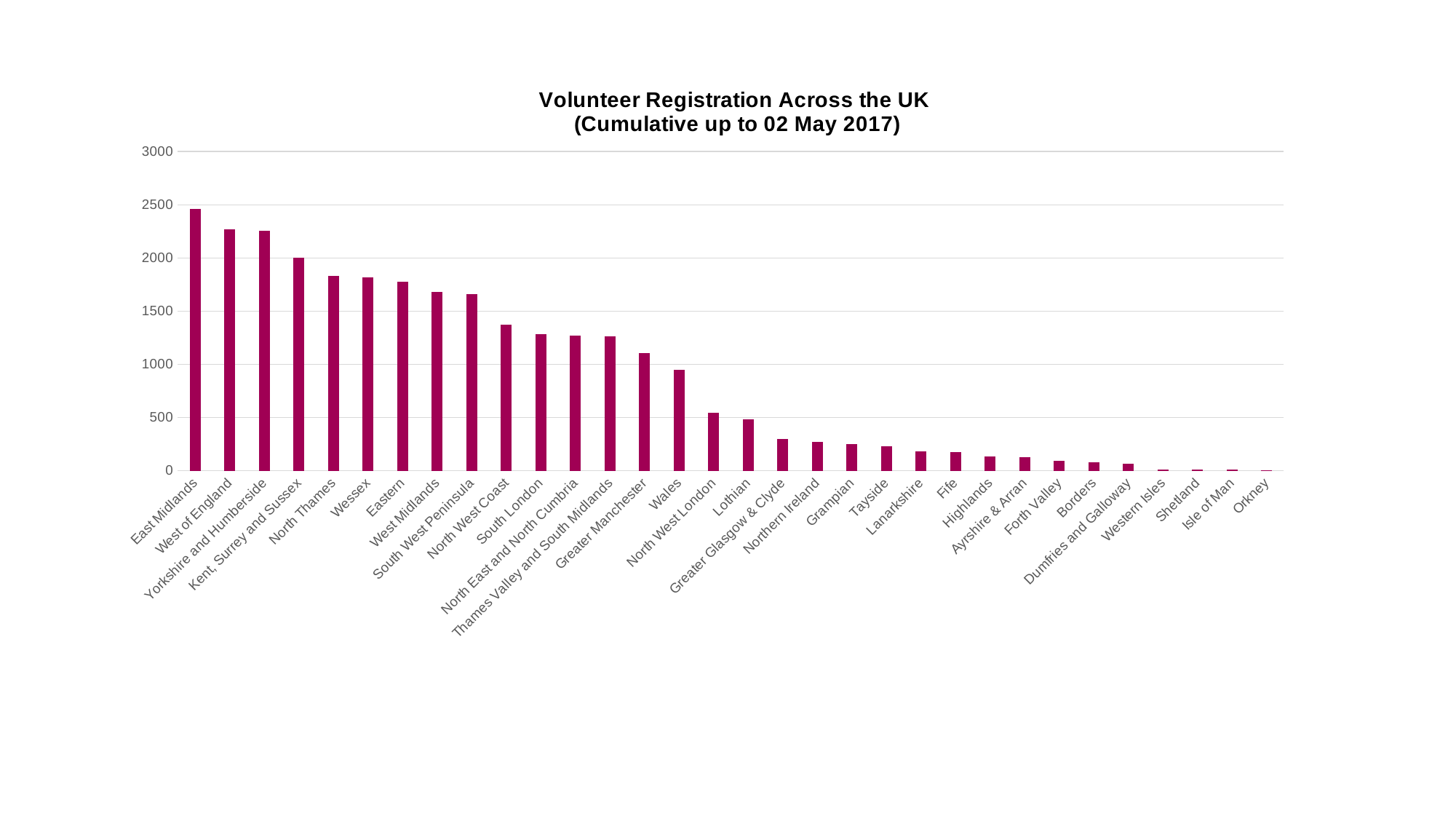
Which is larger, the value for Wales or the value for North West London? Wales Is the value for Wales greater or less than 1000? less Is the value for East Midlands greater or less than 2000? greater How many regions are shown on the x axis of the chart? 32 What is the title of the chart? Volunteer Registration Across the UK (Cumulative up to 02 May 2017) Is the value for Greater Manchester greater or less than 1000? greater Which is larger, the value for East Midlands or the value for West of England? East Midlands What kind of chart is shown on the slide? bar chart Do the values rise or fall moving from left to right along the x axis? fall Which region has the highest volunteer registration? East Midlands